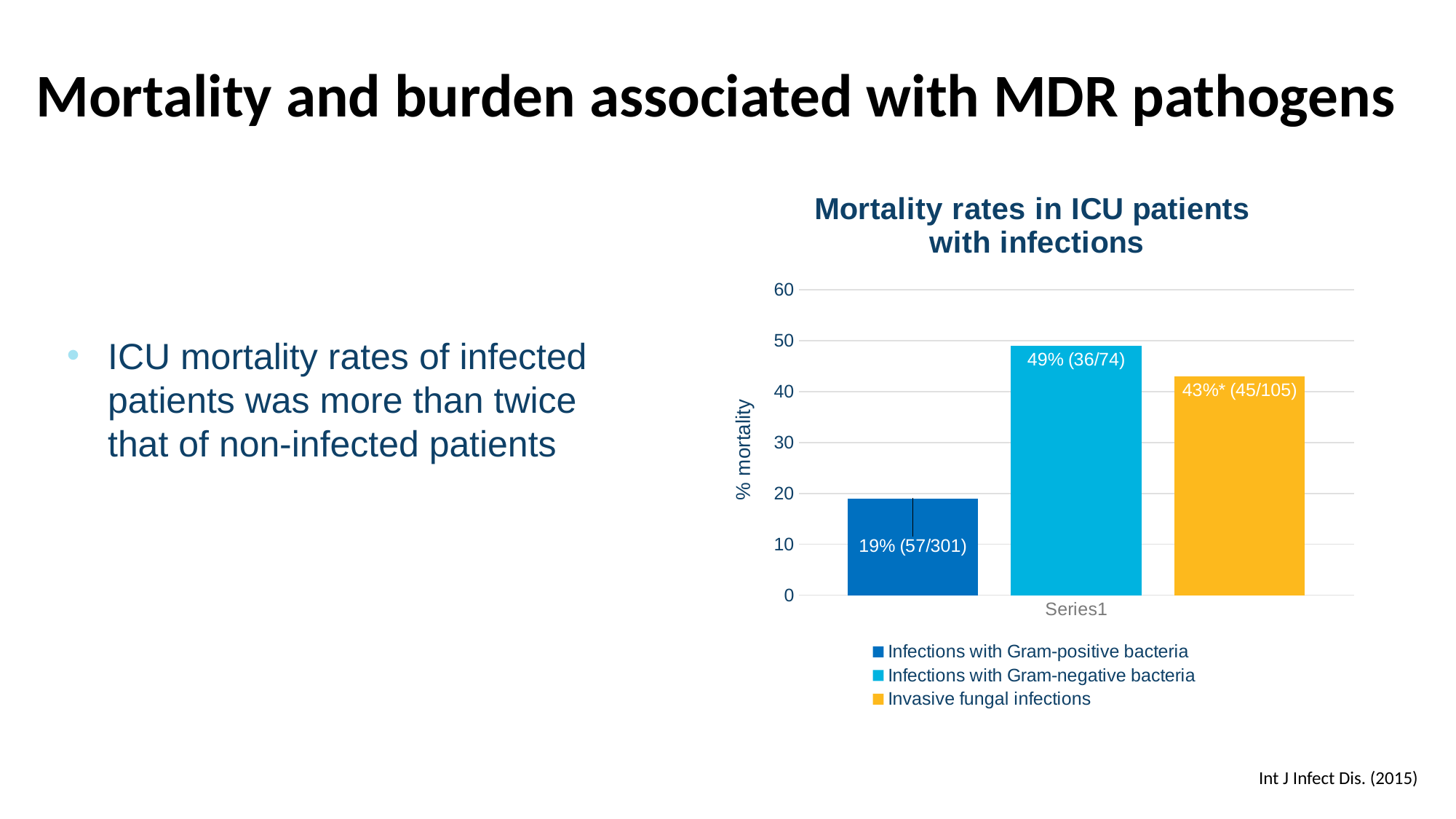
What is the difference in percentage points between the mortality rate for Gram-negative bacterial infections and Gram-positive bacterial infections? 30 Is the mortality rate for invasive fungal infections greater or less than 40? greater What is the mortality rate shown for invasive fungal infections? 43%* (45/105) What is the mortality rate shown for infections with Gram-positive bacteria? 19% (57/301) What is the mortality rate shown for infections with Gram-negative bacteria? 49% (36/74) What kind of chart is shown on the slide? Bar chart What is the title of the chart? Mortality rates in ICU patients with infections How many series does the legend list? 3 Which infection type has the lowest mortality rate? Infections with Gram-positive bacteria Which infection type has the highest mortality rate? Infections with Gram-negative bacteria What is the label on the vertical axis of the chart? % mortality Which has a higher mortality rate: invasive fungal infections or infections with Gram-positive bacteria? Invasive fungal infections